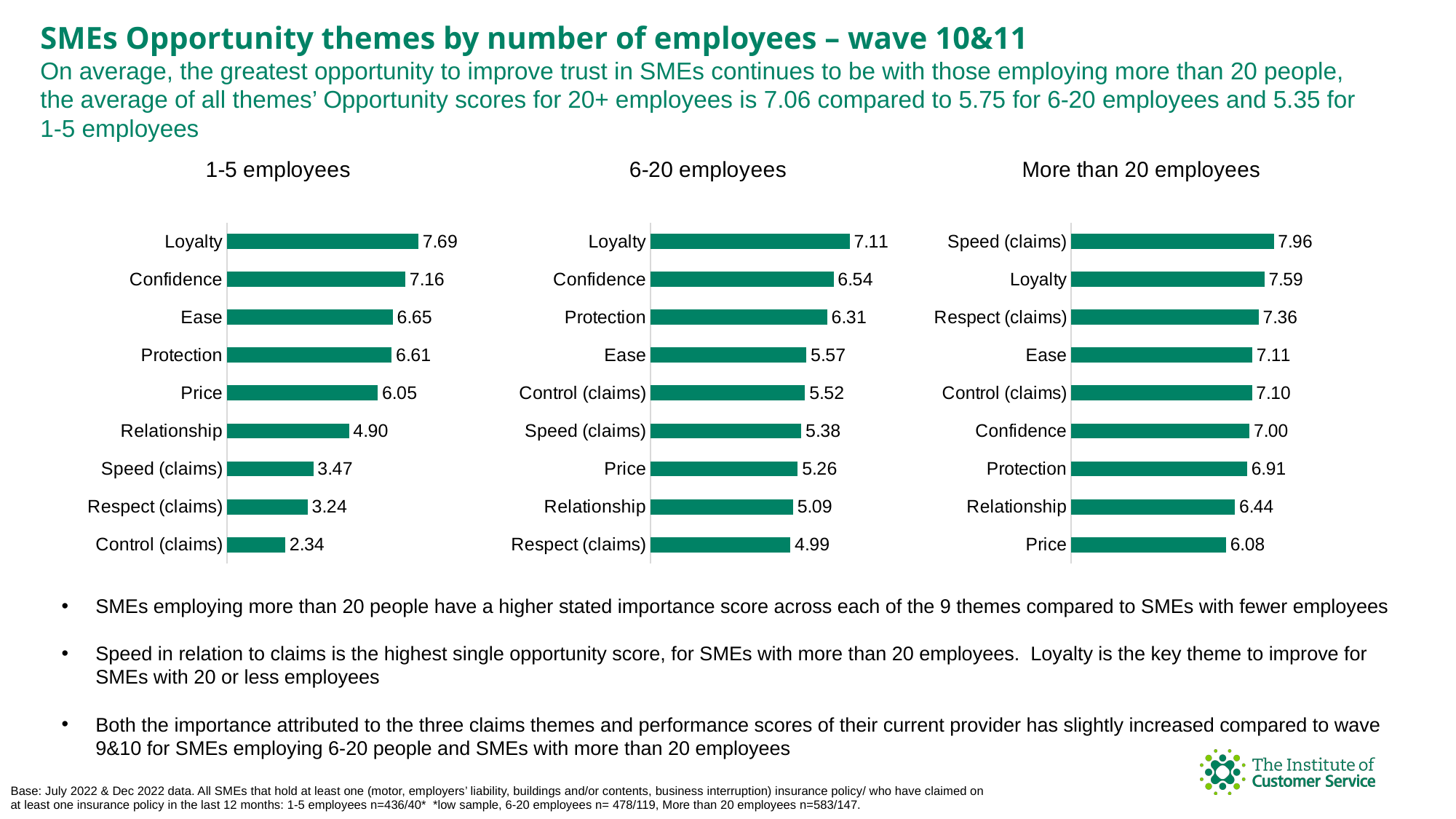
In the '1-5 employees' chart, what is the difference between Loyalty and Confidence? 0.53 In the '1-5 employees' chart, what is the value for Loyalty? 7.69 In the '6-20 employees' chart, which category has the lowest value? Respect (claims) In the '6-20 employees' chart, what is the value for Protection? 6.31 In the 'More than 20 employees' chart, what is the difference between Speed (claims) and Price? 1.88 What type of chart is the '6-20 employees' chart? Bar chart In the '6-20 employees' chart, which is larger: Ease or Price? Ease What is the title of the chart on the right of the slide? More than 20 employees In the 'More than 20 employees' chart, which category has the highest value? Speed (claims) In the 'More than 20 employees' chart, what is the value for Relationship? 6.44 In the '1-5 employees' chart, which category has the lowest value? Control (claims) How many categories are shown in the '1-5 employees' chart? 9